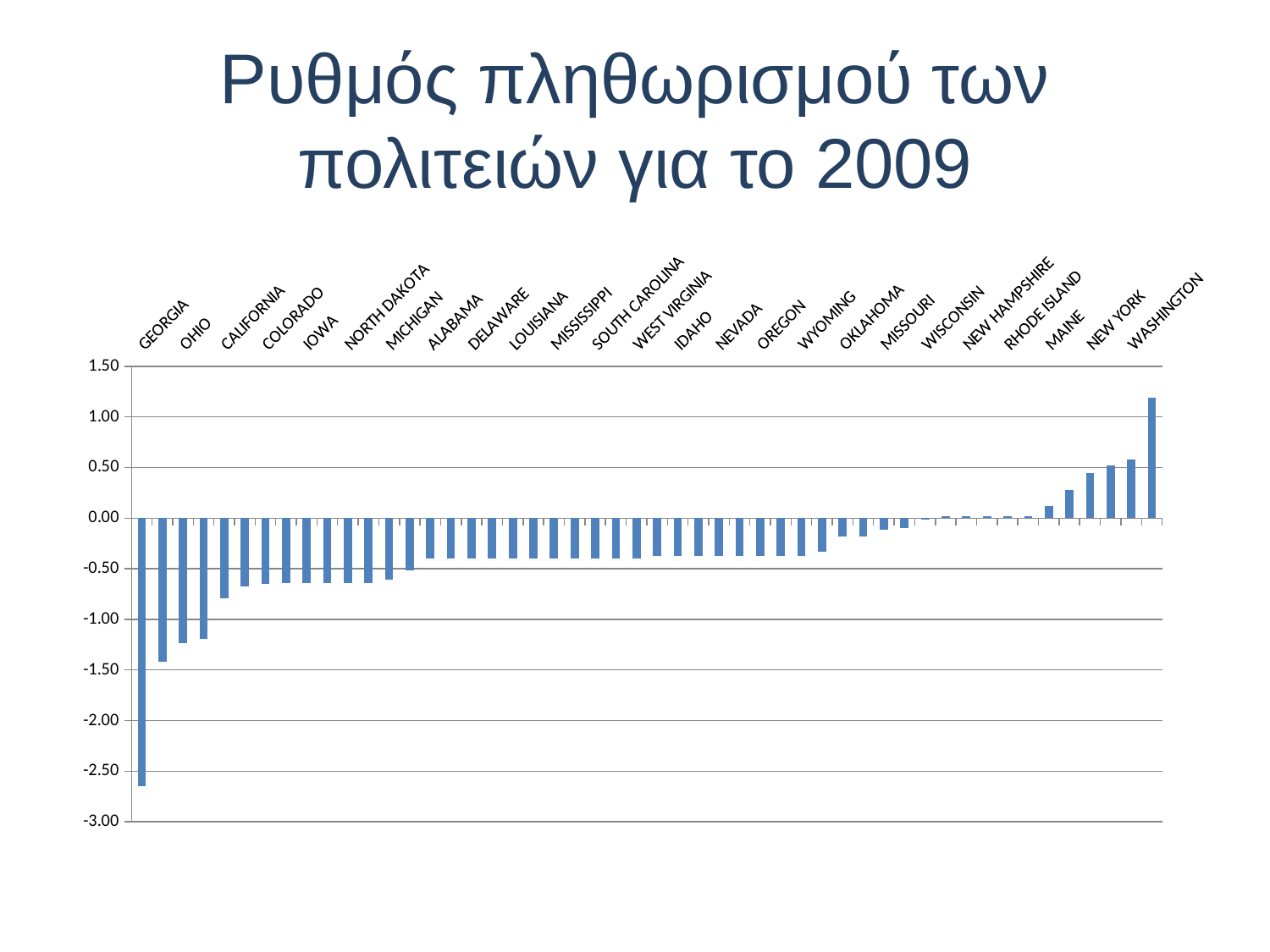
Which state has the lowest inflation rate in the chart? Georgia Is the value for Wyoming greater or less than 0.00? less Is the value for Washington greater or less than 1.00? less What kind of chart is shown on the slide? bar chart Is the value for Maine greater or less than 0.00? greater What is the title of the chart on the slide? Ρυθμός πληθωρισμού των πολιτειών για το 2009 Which is larger, the value for Georgia or the value for Washington? Washington Do the values generally rise or fall moving from left to right along the x axis? rise